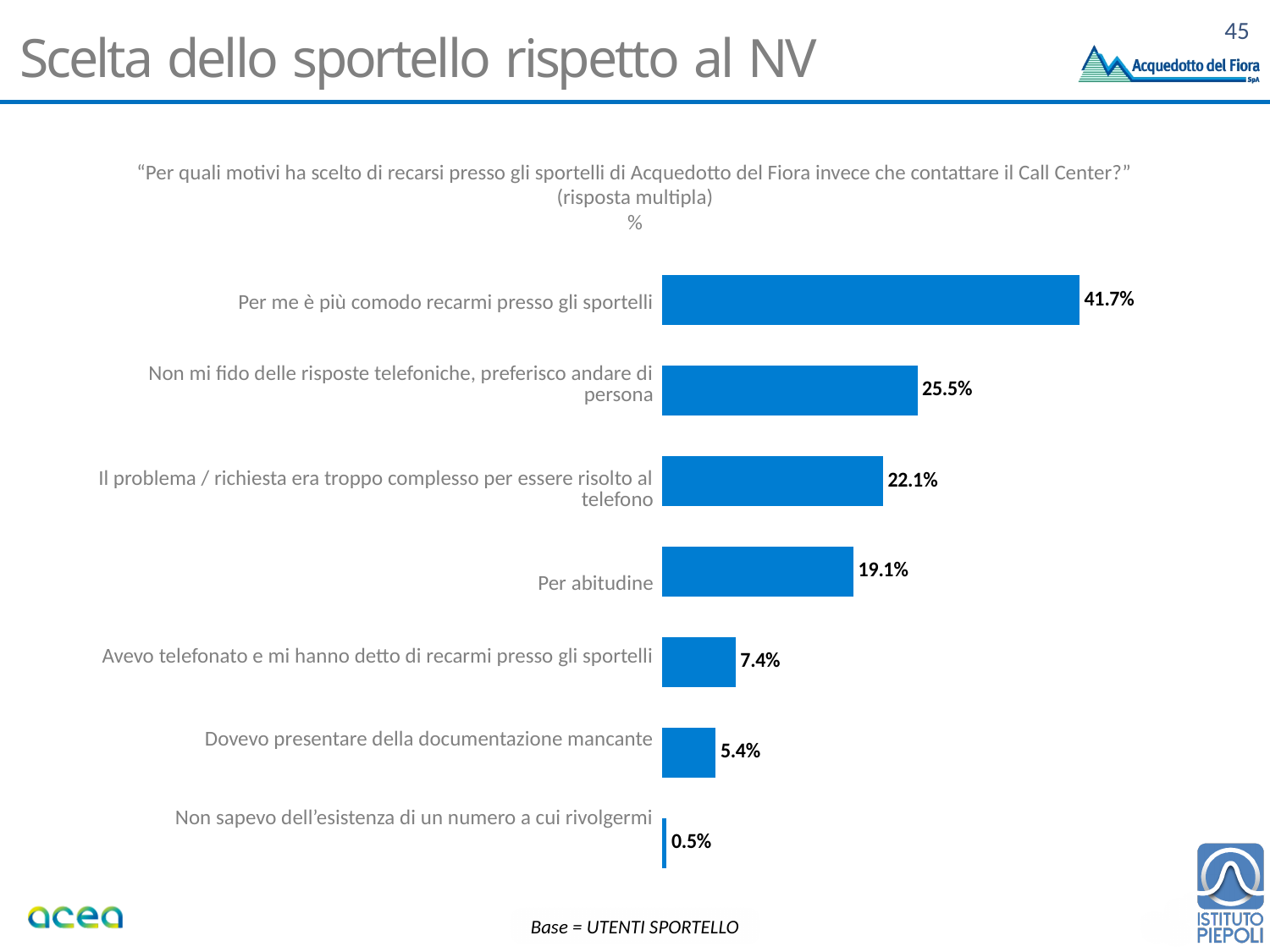
What kind of chart is shown on the slide? Bar chart Which category has the lowest value? Non sapevo dell'esistenza di un numero a cui rivolgermi What is the value for "Non mi fido delle risposte telefoniche, preferisco andare di persona"? 25.5% What is the value for "Dovevo presentare della documentazione mancante"? 5.4% What is the difference between the values for "Non mi fido delle risposte telefoniche, preferisco andare di persona" and "Il problema / richiesta era troppo complesso per essere risolto al telefono"? 3.4% How many categories are shown in the chart? 7 What is the value for "Per me è più comodo recarmi presso gli sportelli"? 41.7% Which is larger: the value for "Avevo telefonato e mi hanno detto di recarmi presso gli sportelli" or for "Dovevo presentare della documentazione mancante"? Avevo telefonato e mi hanno detto di recarmi presso gli sportelli What base is stated below the chart? UTENTI SPORTELLO Which category has the highest value? Per me è più comodo recarmi presso gli sportelli What is the value for "Per abitudine"? 19.1% What is the difference between the highest and lowest values in the chart? 41.2%